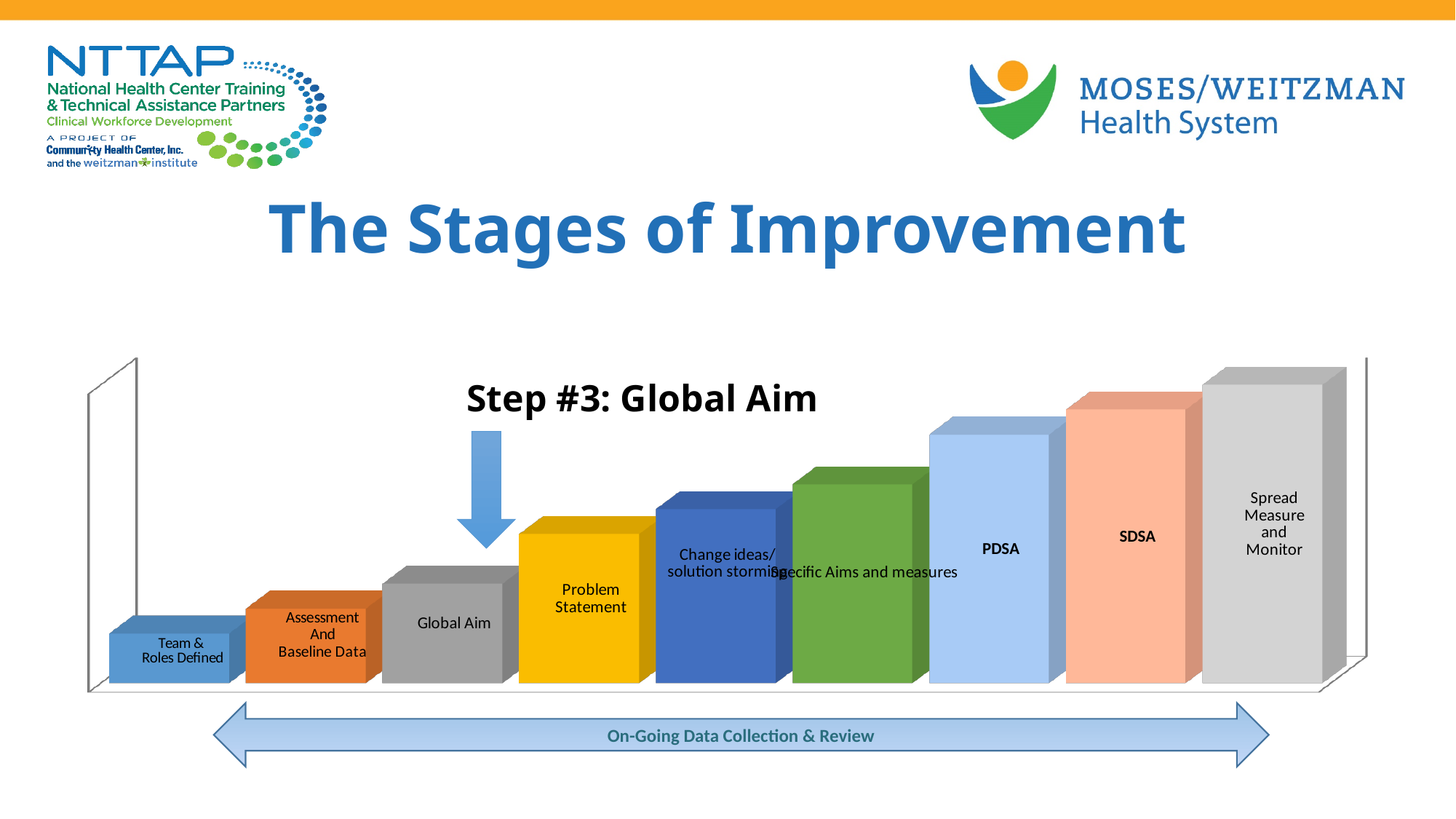
How many bars (stages) are shown in the chart? 9 What is the title of the slide containing the chart? The Stages of Improvement What kind of chart is shown on the slide? Bar chart What text is written on the double-headed arrow below the chart? On-Going Data Collection & Review Which bar is taller, Team & Roles Defined or Problem Statement? Problem Statement What is the label of the first (leftmost) bar in the chart? Team & Roles Defined Which bar is taller, PDSA or Global Aim? PDSA Do the bars rise or fall from left to right across the chart? Rise What is the label of the bar immediately after Global Aim? Problem Statement Which stage has the tallest bar in the chart? Spread Measure and Monitor Which stage has the shortest bar in the chart? Team & Roles Defined Which bar is taller, SDSA or Spread Measure and Monitor? Spread Measure and Monitor